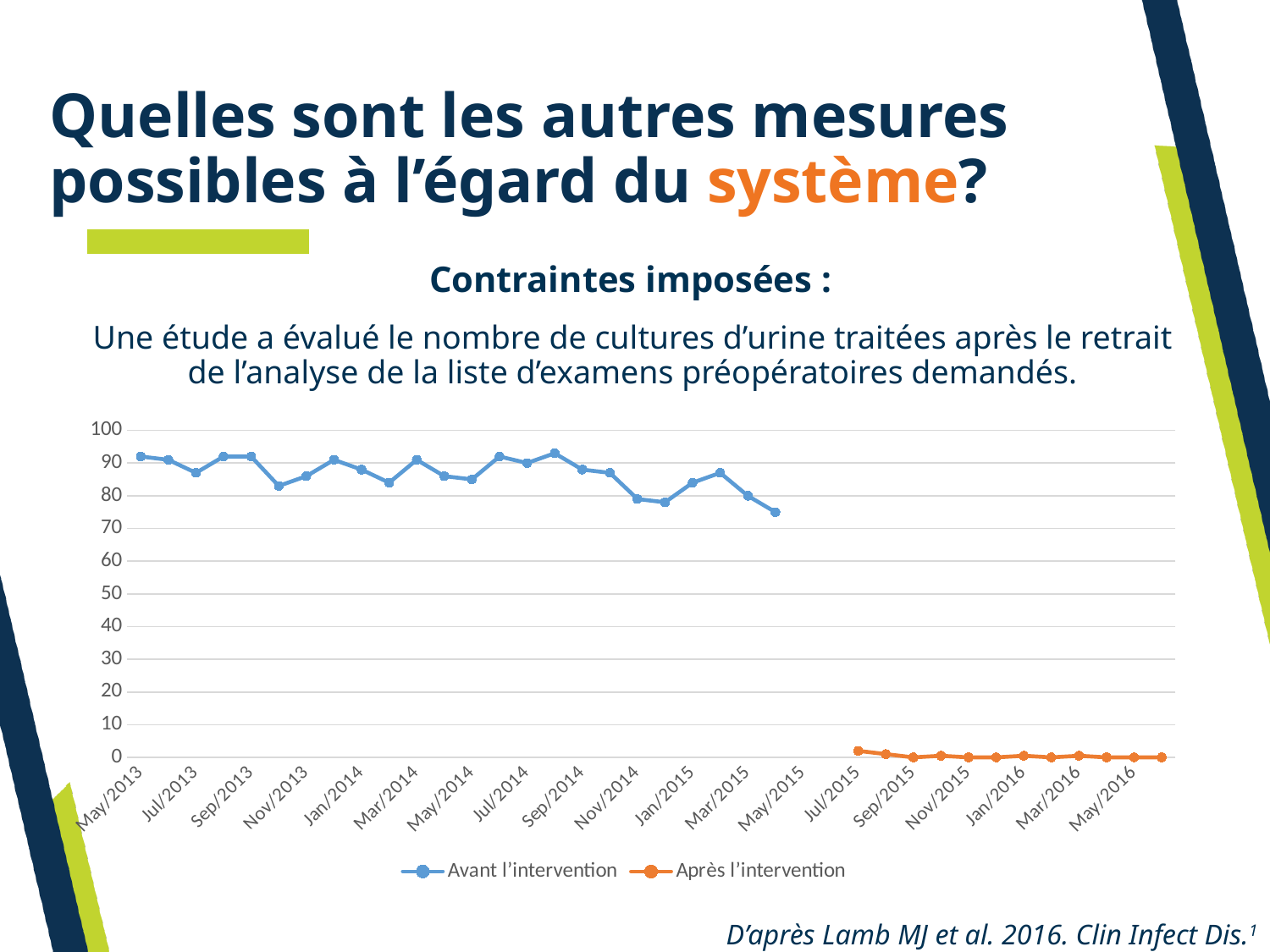
Is the value for 'Avant l'intervention' at Nov/2014 greater or less than 90? less Do the values of the 'Avant l'intervention' series rise or fall overall from May/2013 to May/2015? fall What colour is the line for the series 'Après l'intervention'? orange How many series does the chart legend list? 2 Is the value for 'Après l'intervention' at Jul/2015 greater or less than 10? less What kind of chart is shown on the slide? line chart Is the value for 'Avant l'intervention' at May/2013 greater or less than 80? greater Which series has the higher values overall, 'Avant l'intervention' or 'Après l'intervention'? Avant l'intervention What are the two series named in the chart legend? Avant l'intervention, Après l'intervention